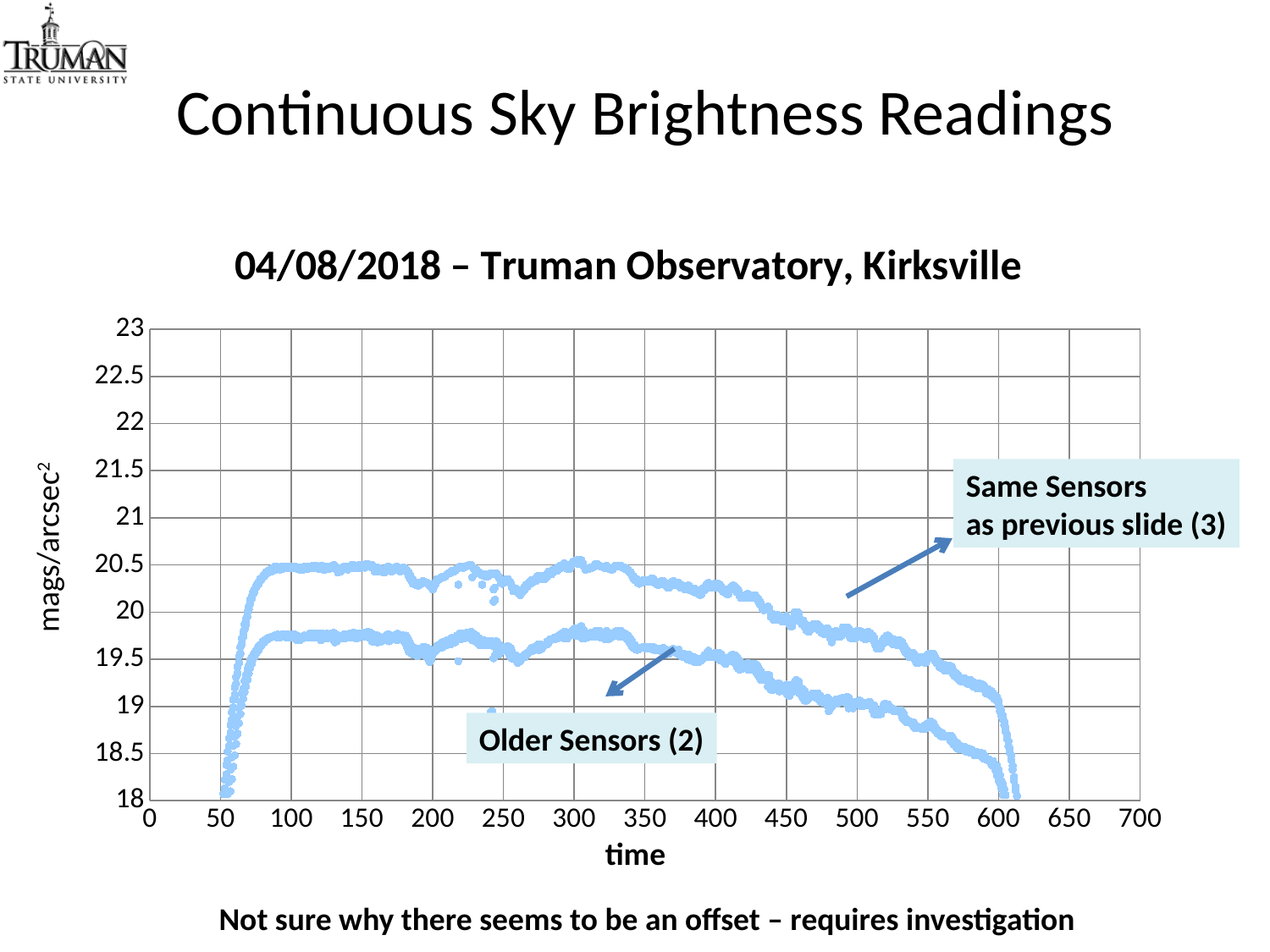
Is the value for the Older Sensors (2) at time 100 greater or less than 20? less Is the value for the Older Sensors (2) at time 100 greater or less than 19.5? greater Is the value for the Same Sensors as previous slide (3) at time 500 greater or less than 20? less What kind of chart is shown on the slide? scatter chart Between time 400 and time 600, do the readings for the Same Sensors as previous slide (3) rise or fall? fall At time 300, which group of readings is higher: the Same Sensors as previous slide (3) or the Older Sensors (2)? Same Sensors as previous slide (3) What is the label of the y axis of the chart? mags/arcsec² What is the highest value shown on the y axis of the chart? 23 What is the title of the chart? 04/08/2018 – Truman Observatory, Kirksville